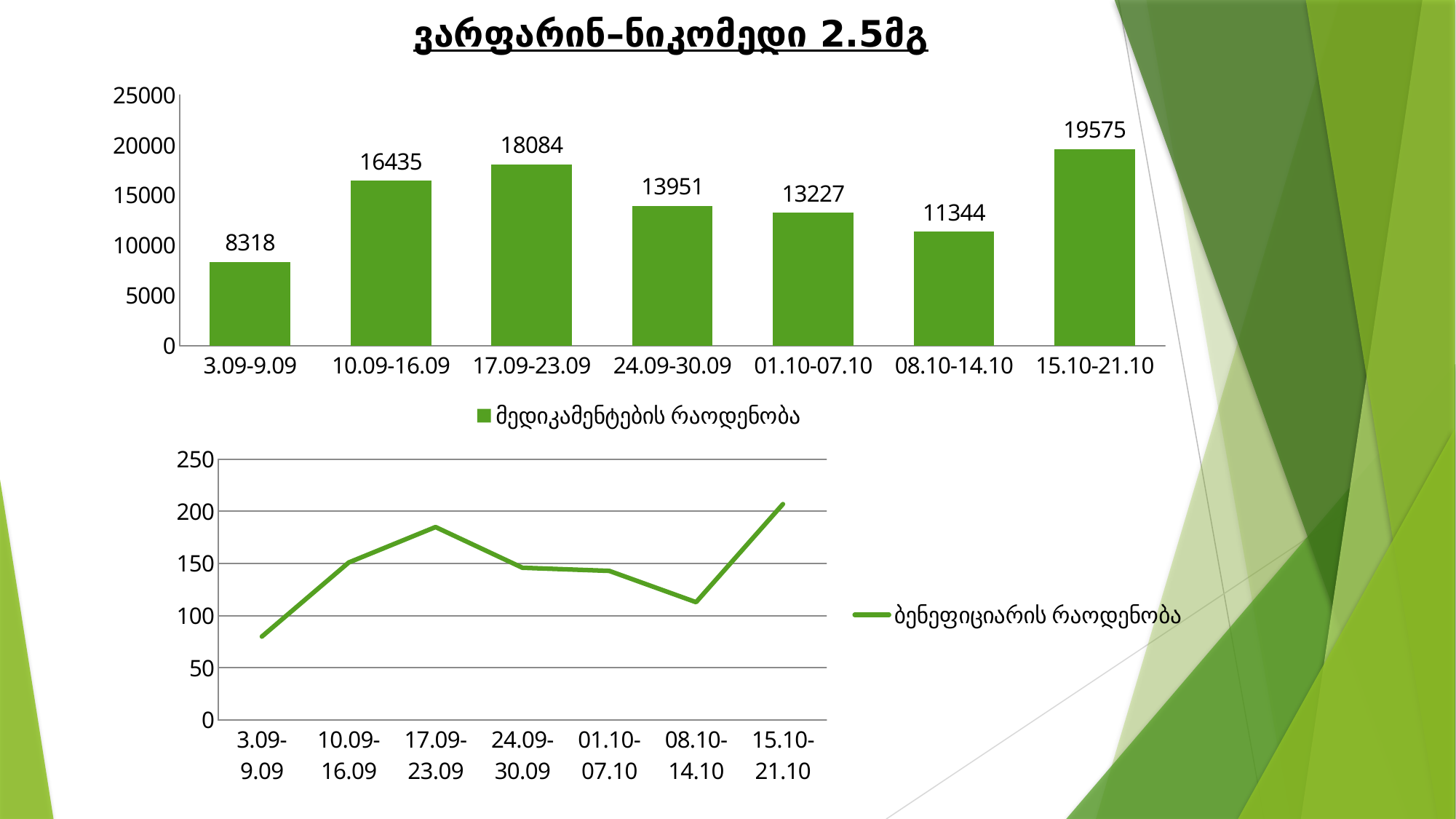
What is the title of the slide's chart? ვარფარინ-ნიკომედი 2.5მგ What kind of chart is the top chart on the slide? bar chart On the top bar chart, which period has the highest value? 15.10-21.10 On the bottom line chart, is the value for 3.09-9.09 greater or less than 100? less On the top bar chart, what is the value for 3.09-9.09? 8318 How many bars are there on the top bar chart? 7 On the top bar chart, which period has the lowest value? 3.09-9.09 On the bottom line chart, is the value for 17.09-23.09 greater or less than 150? greater What kind of chart is the bottom chart on the slide? line chart On the top bar chart, what is the value for 01.10-07.10? 13227 On the top bar chart, which is larger: the value for 24.09-30.09 or the value for 08.10-14.10? 24.09-30.09 On the top bar chart, what is the difference between the values for 17.09-23.09 and 10.09-16.09? 1649